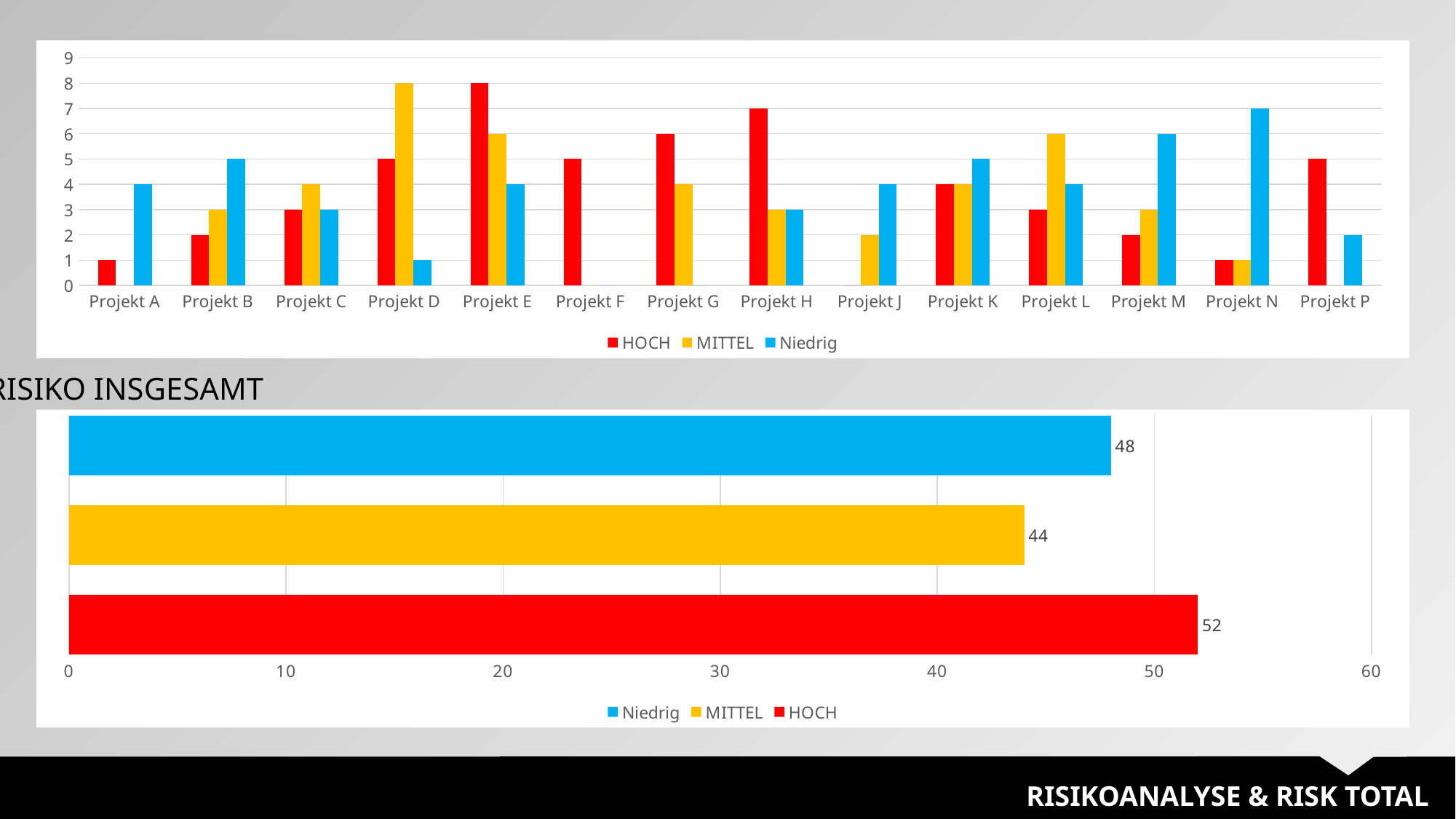
In the top chart, what is the Niedrig value for Projekt N? 7 In the bottom chart (RISIKO INSGESAMT), which series has the lowest value? MITTEL In the bottom chart (RISIKO INSGESAMT), is the value for Niedrig greater or less than 50? less In the bottom chart (RISIKO INSGESAMT), what is the difference between the HOCH and MITTEL values? 8 In the bottom chart (RISIKO INSGESAMT), what is the value for HOCH? 52 How many series does the legend of the top chart list? 3 What kind of chart is the bottom chart (RISIKO INSGESAMT)? bar chart In the top chart, what is the MITTEL value for Projekt D? 8 In the bottom chart (RISIKO INSGESAMT), what is the value for Niedrig? 48 In the top chart, is the HOCH value for Projekt H larger or the Niedrig value for Projekt H? HOCH In the top chart, which project has the highest HOCH value? Projekt E In the top chart, how many projects are shown on the x axis? 14